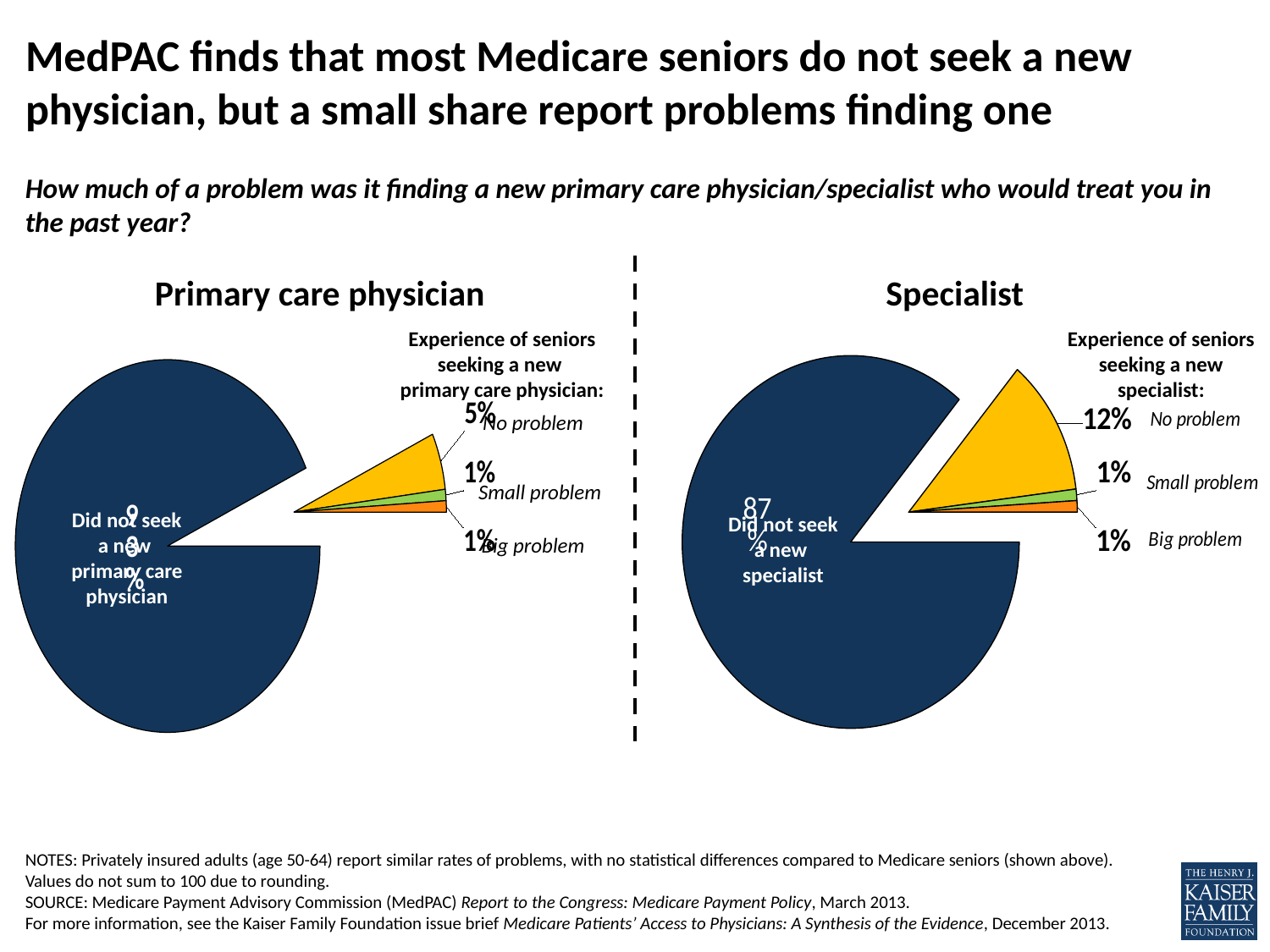
In the Specialist chart, what share reported a big problem finding a new specialist? 1% What kind of chart is used on this slide for the Primary care physician and Specialist data? Pie chart What is the difference between the 'No problem' share in the Specialist chart and the 'No problem' share in the Primary care physician chart? 7 percentage points What is the title of the pie chart on the left side of the slide? Primary care physician In the Primary care physician chart, what share reported a small problem finding a new primary care physician? 1% In the Specialist chart, what share of seniors seeking a new specialist reported no problem? 12% How many slices does the Specialist pie chart have? 4 In the Specialist chart, which of the three experience categories for seniors seeking a new specialist has the largest share? No problem In the Specialist chart, what share of seniors did not seek a new specialist? 87% Which chart shows a larger 'No problem' share, Primary care physician or Specialist? Specialist In the Primary care physician chart, what colour is the slice for seniors who did not seek a new primary care physician? Dark blue In the Primary care physician chart, what share of seniors seeking a new primary care physician reported no problem? 5%